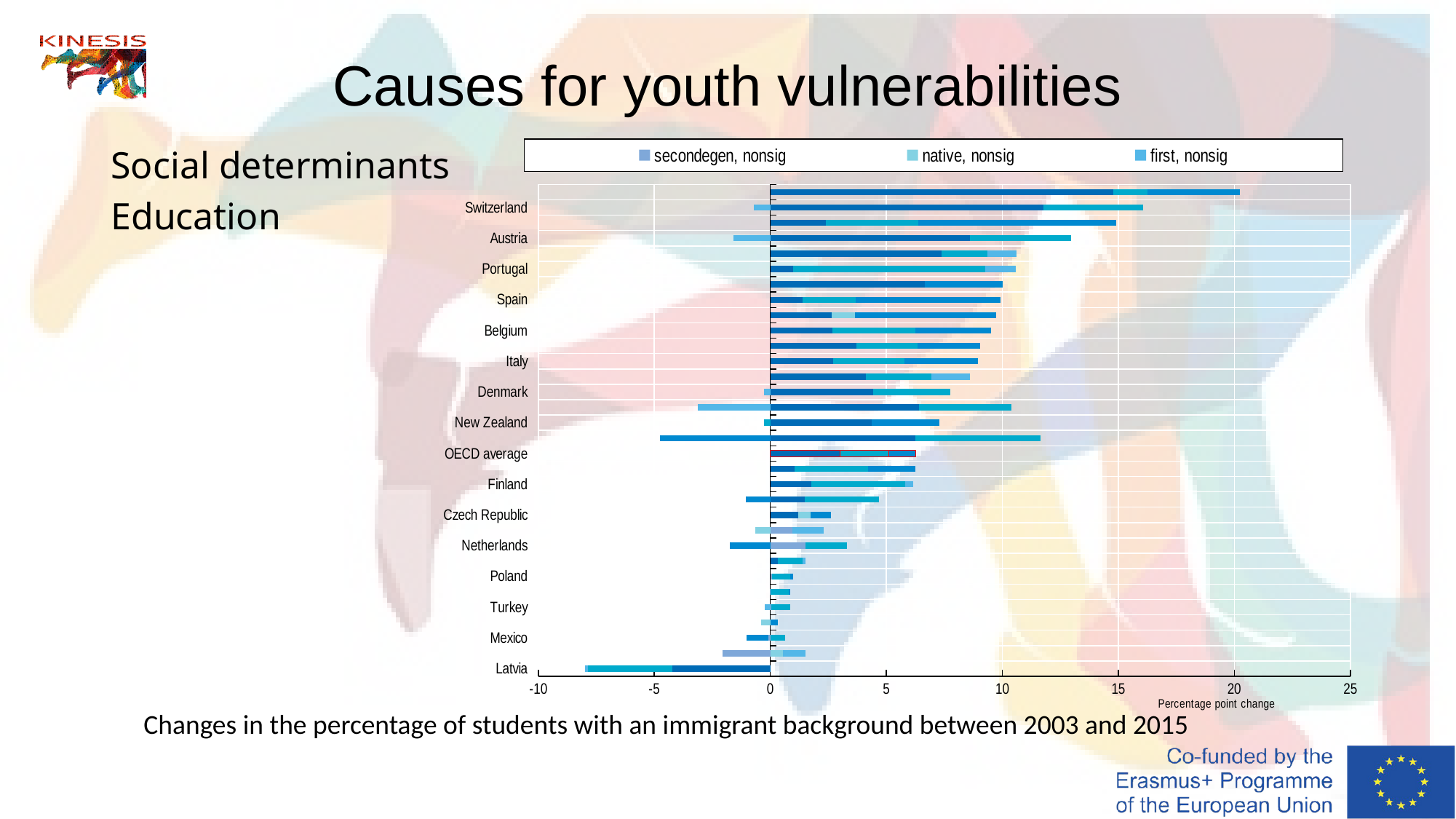
What is the label of the horizontal axis? Percentage point change Which labeled country has the lowest (most negative) value? Latvia Do the bar values generally rise or fall going from the top of the chart (Switzerland) to the bottom (Latvia)? fall Is the value for Czech Republic greater or less than 5? less Is the value for Austria greater or less than 10? greater How many series does the legend list? 3 What are the three series named in the legend? secondegen, nonsig; native, nonsig; first, nonsig Is the value for Switzerland greater or less than 10? greater What kind of chart is shown on the slide? Bar chart Which has the larger value, Switzerland or Latvia? Switzerland